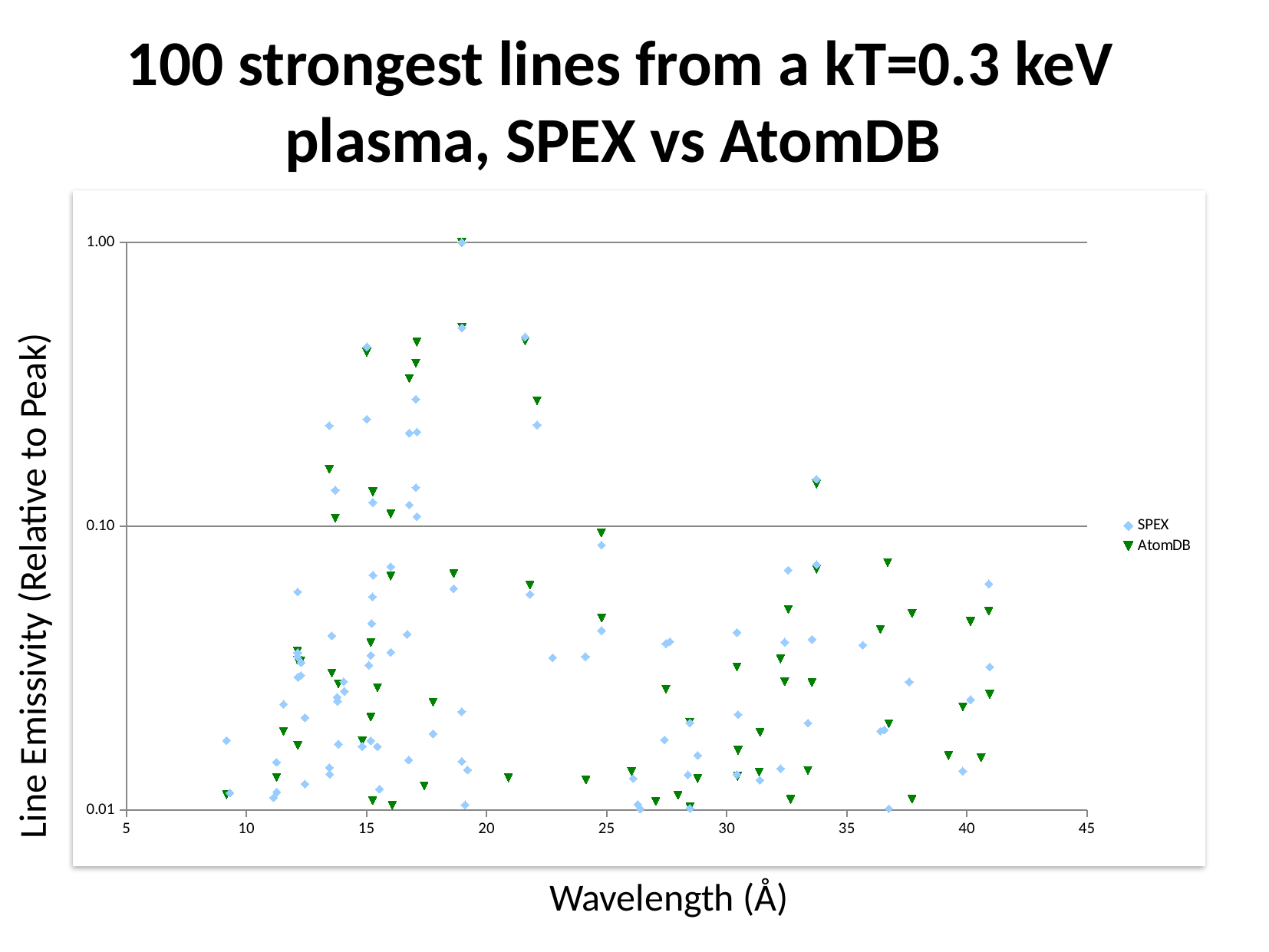
Is the highest value plotted near 40 Å greater or less than 0.10? less Is the highest value plotted near 30 Å greater or less than 0.10? less What kind of chart is shown on the slide? Scatter chart What is the label of the vertical axis? Line Emissivity (Relative to Peak) Is the highest value plotted near 15 Å greater or less than 0.10? greater What is the highest line emissivity value reached by any point on the chart? 1.00 How many series does the legend list? 2 What are the two series named in the legend? SPEX and AtomDB